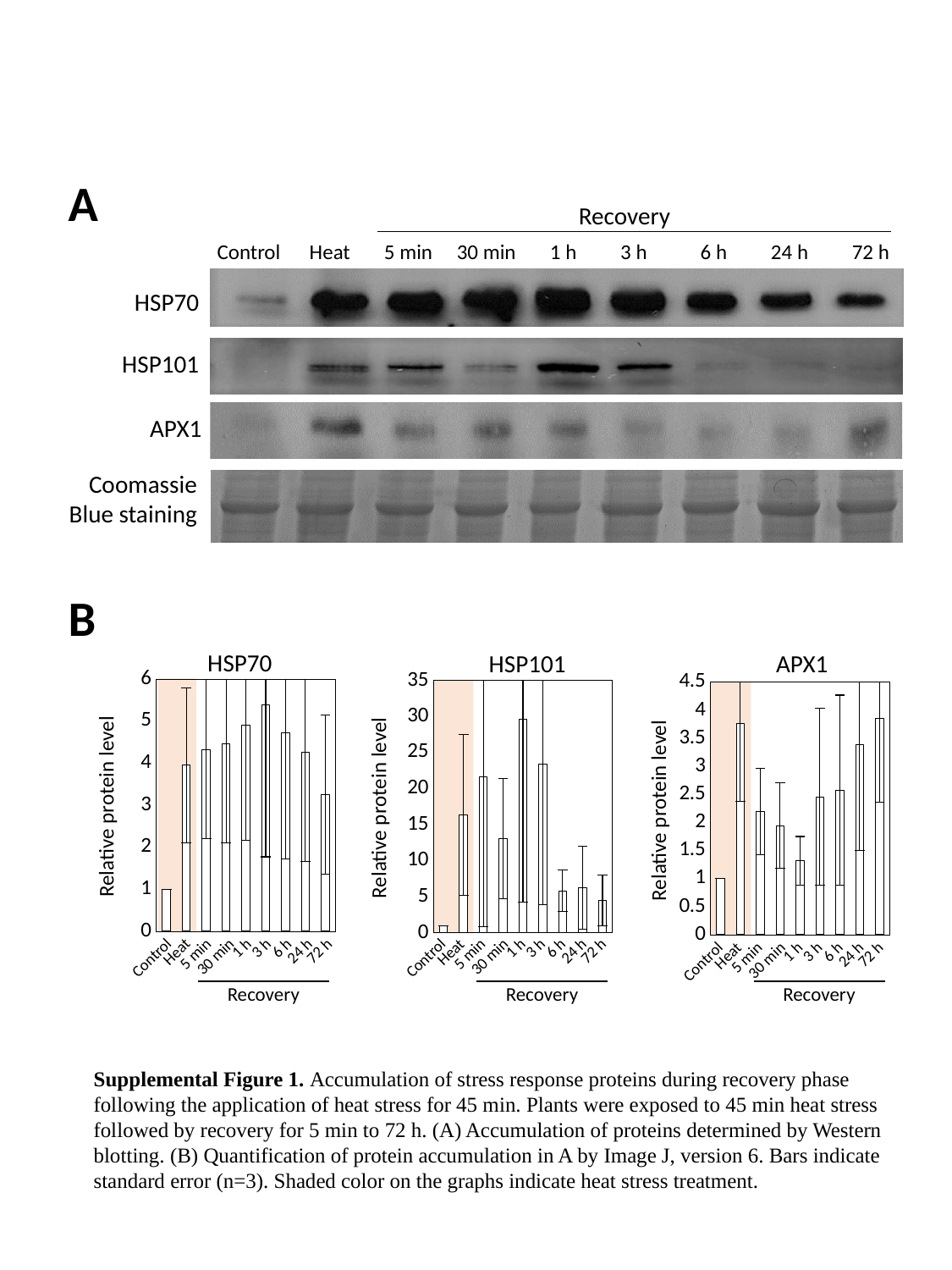
In the HSP101 chart, is the value for 6 h greater or less than 10? less In the HSP70 chart, is the value for Heat greater or less than 3? greater In the HSP101 chart, which category has the highest relative protein level? 1 h In the HSP70 chart, is the value for 3 h greater or less than 5? greater What is the y-axis label on the APX1 chart? Relative protein level In the HSP101 chart, which category has the lowest relative protein level? Control In the HSP70 chart, how many categories are shown on the x axis? 9 In the HSP70 chart, which category has the highest relative protein level? 3 h In panel B, what kind of chart is the HSP70 chart? bar chart In the APX1 chart, which is larger, the value for 5 min or the value for 1 h? 5 min